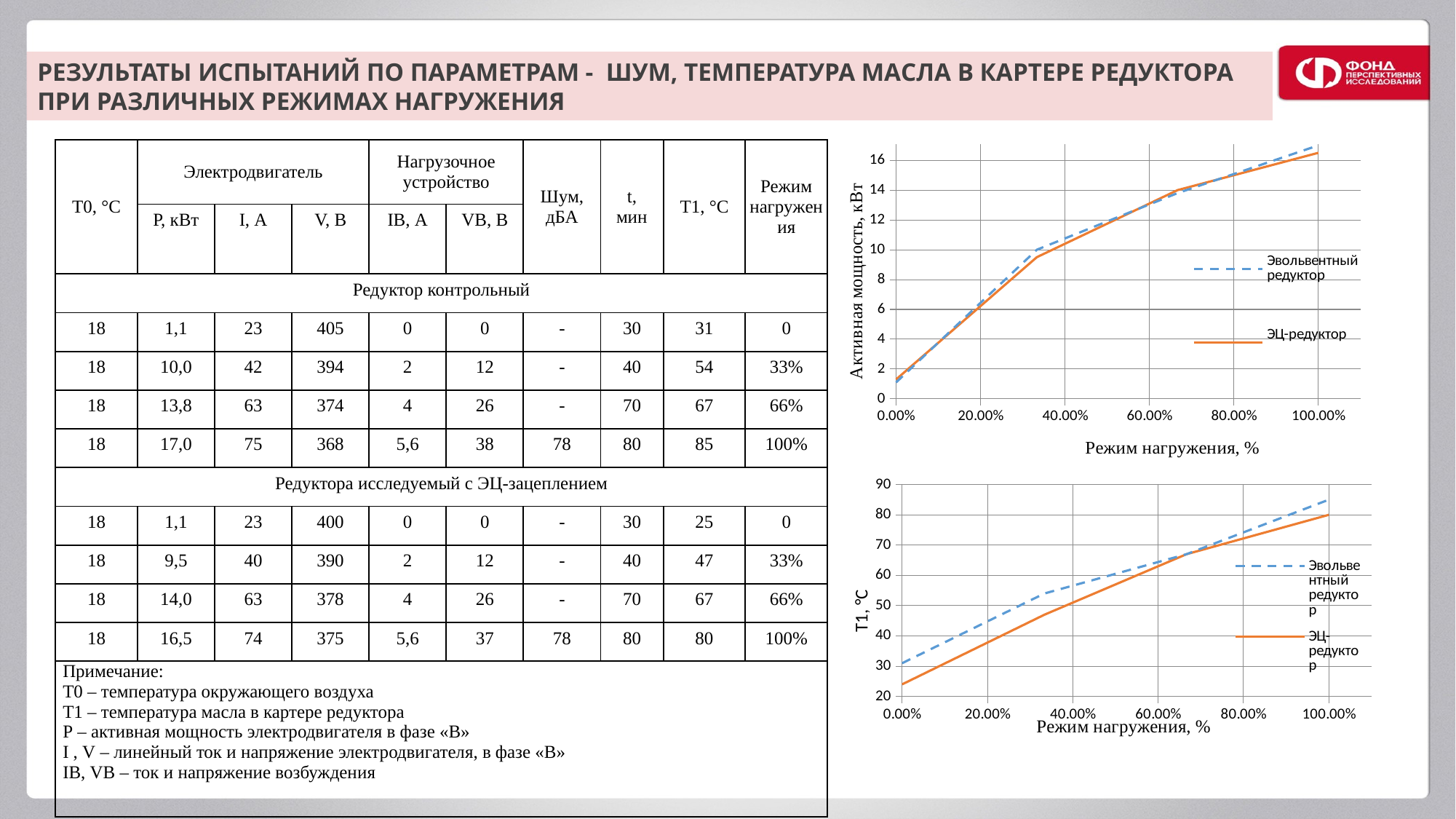
In the bottom chart (T1, °C), is the value for ЭЦ-редуктор at 0.00% greater or less than 30? less In the top chart (Активная мощность, кВт), do the values rise or fall as Режим нагружения increases from 0.00% to 100.00%? rise What kind of chart is the top chart on the right of the slide? line chart What is the x-axis title of the bottom chart? Режим нагружения, % In the top chart, which series is drawn with a dashed line? Эвольвентный редуктор How many series does the legend of the top chart (Активная мощность, кВт) list? 2 In the bottom chart (T1, °C), which series has the higher value at 0.00%, Эвольвентный редуктор or ЭЦ-редуктор? Эвольвентный редуктор In the bottom chart (T1, °C), is the value for Эвольвентный редуктор at 100.00% greater or less than 80? greater In the bottom chart (T1, °C), what is the value for ЭЦ-редуктор at 100.00%? 80 In the bottom chart (T1, °C), do the values rise or fall as Режим нагружения increases? rise In the top chart (Активная мощность, кВт), is the value for Эвольвентный редуктор at 100.00% greater or less than 16? greater